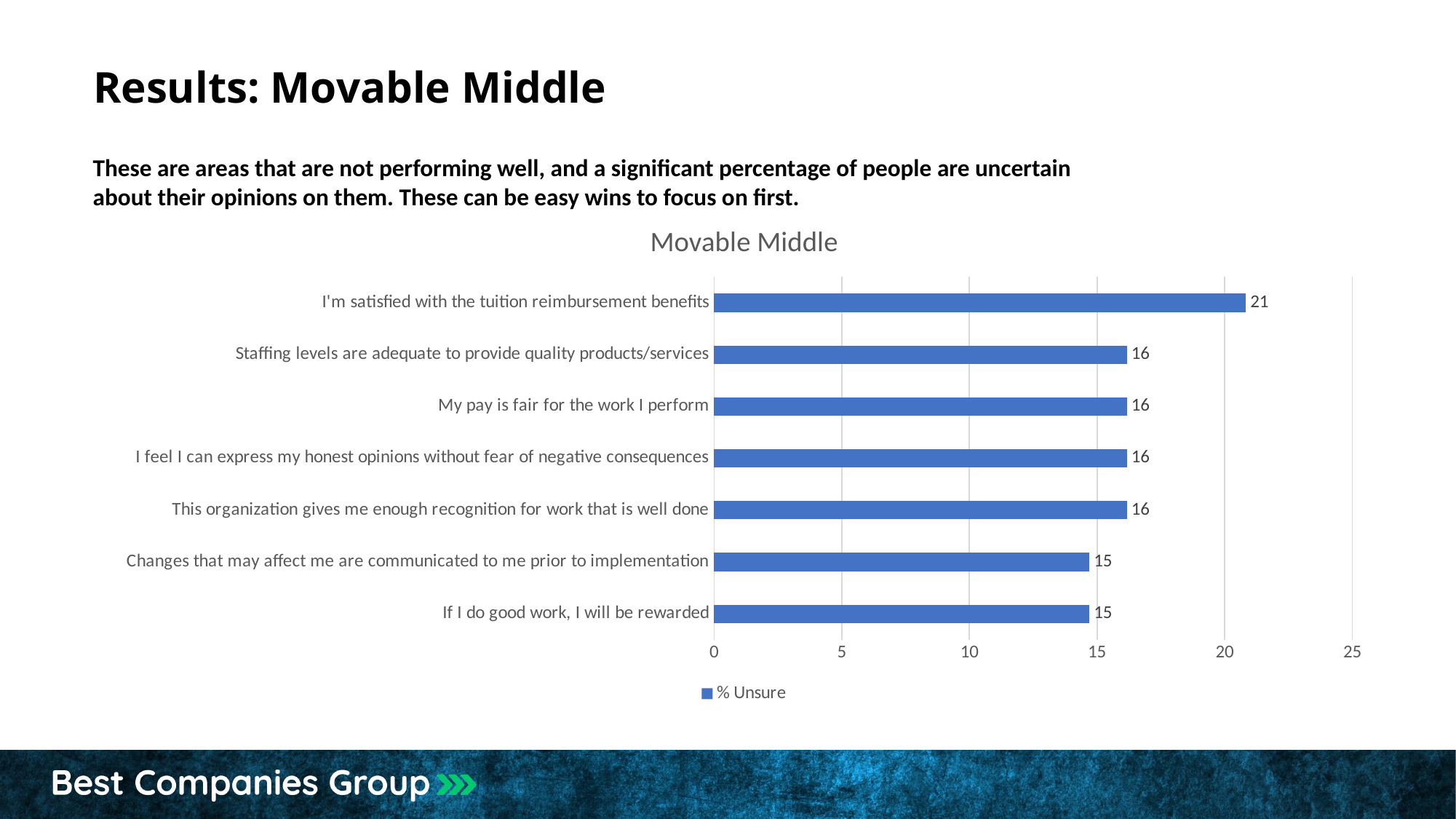
Which category has the highest % Unsure value? I'm satisfied with the tuition reimbursement benefits What is the % Unsure value for "My pay is fair for the work I perform"? 16 How many series does the legend list? 1 What is the % Unsure value for "I'm satisfied with the tuition reimbursement benefits"? 21 Is the value for "I'm satisfied with the tuition reimbursement benefits" greater or less than 20? greater What is the difference between the % Unsure values for "I'm satisfied with the tuition reimbursement benefits" and "If I do good work, I will be rewarded"? 6 How many categories are shown in the chart? 7 What is the % Unsure value for "Changes that may affect me are communicated to me prior to implementation"? 15 Is the value for "If I do good work, I will be rewarded" greater or less than 20? less What is the title of the chart? Movable Middle Which has a larger % Unsure value: "Staffing levels are adequate to provide quality products/services" or "If I do good work, I will be rewarded"? Staffing levels are adequate to provide quality products/services What kind of chart is shown on the slide? Bar chart